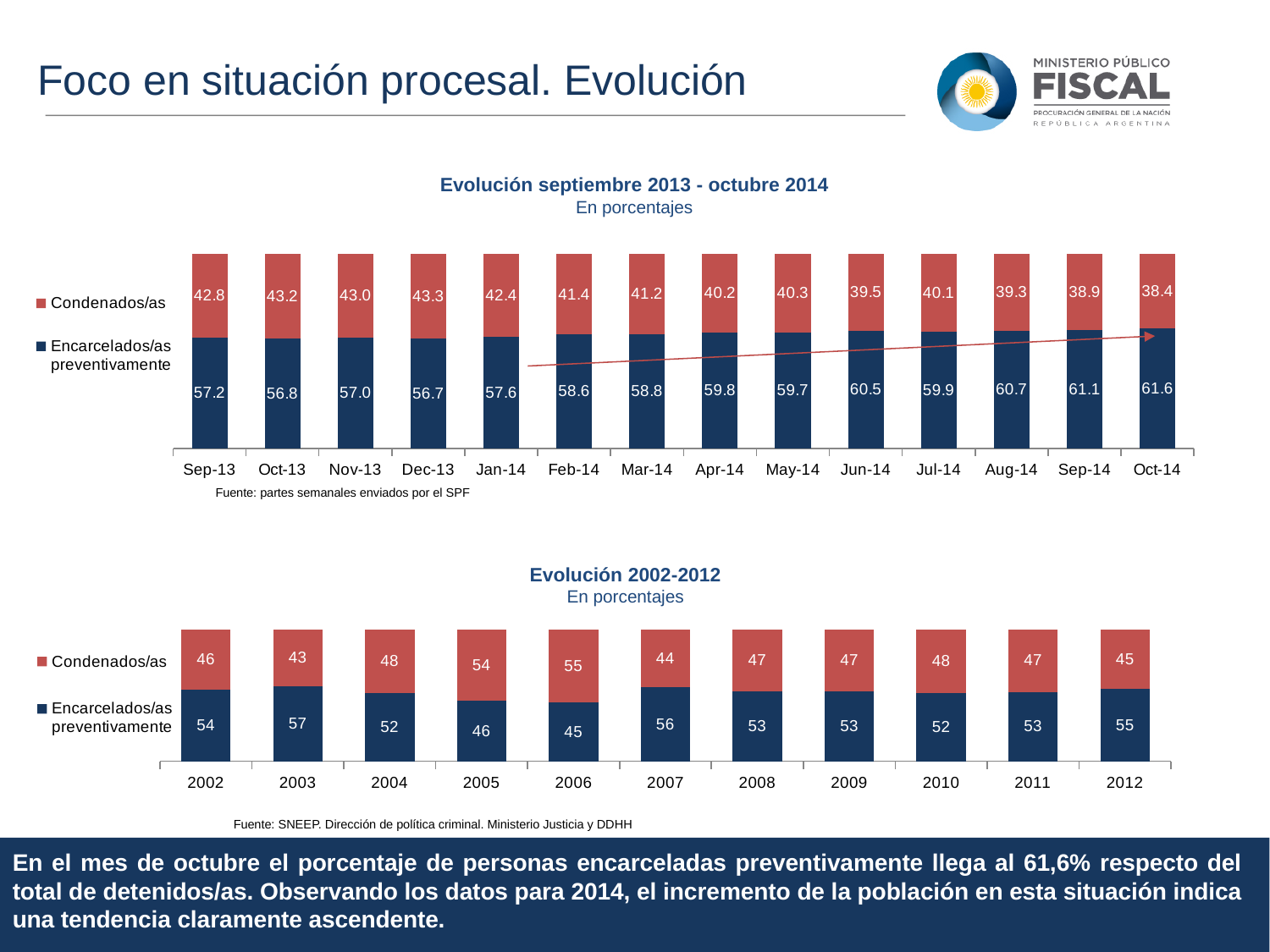
In the chart titled 'Evolución 2002-2012', how many series does the legend list? 2 In the chart titled 'Evolución septiembre 2013 - octubre 2014', which month has the highest value for Encarcelados/as preventivamente? Oct-14 In the chart titled 'Evolución 2002-2012', which is larger in 2005: Condenados/as or Encarcelados/as preventivamente? Condenados/as In the chart titled 'Evolución septiembre 2013 - octubre 2014', does the Encarcelados/as preventivamente value generally rise or fall from Sep-13 to Oct-14? rise In the chart titled 'Evolución 2002-2012', which year has the highest value for Encarcelados/as preventivamente? 2003 In the chart titled 'Evolución septiembre 2013 - octubre 2014', what is the difference between the Encarcelados/as preventivamente values for Oct-14 and Sep-13? 4.4 In the chart titled 'Evolución septiembre 2013 - octubre 2014', how many months are shown on the x axis? 14 What kind of chart is the chart titled 'Evolución 2002-2012'? stacked bar chart In the chart titled 'Evolución 2002-2012', what is the value for Condenados/as in 2006? 55 In the chart titled 'Evolución septiembre 2013 - octubre 2014', which month has the lowest value for Encarcelados/as preventivamente? Dec-13 In the chart titled 'Evolución septiembre 2013 - octubre 2014', what is the value for Condenados/as in Sep-13? 42.8 In the chart titled 'Evolución septiembre 2013 - octubre 2014', what is the value for Encarcelados/as preventivamente in Oct-14? 61.6